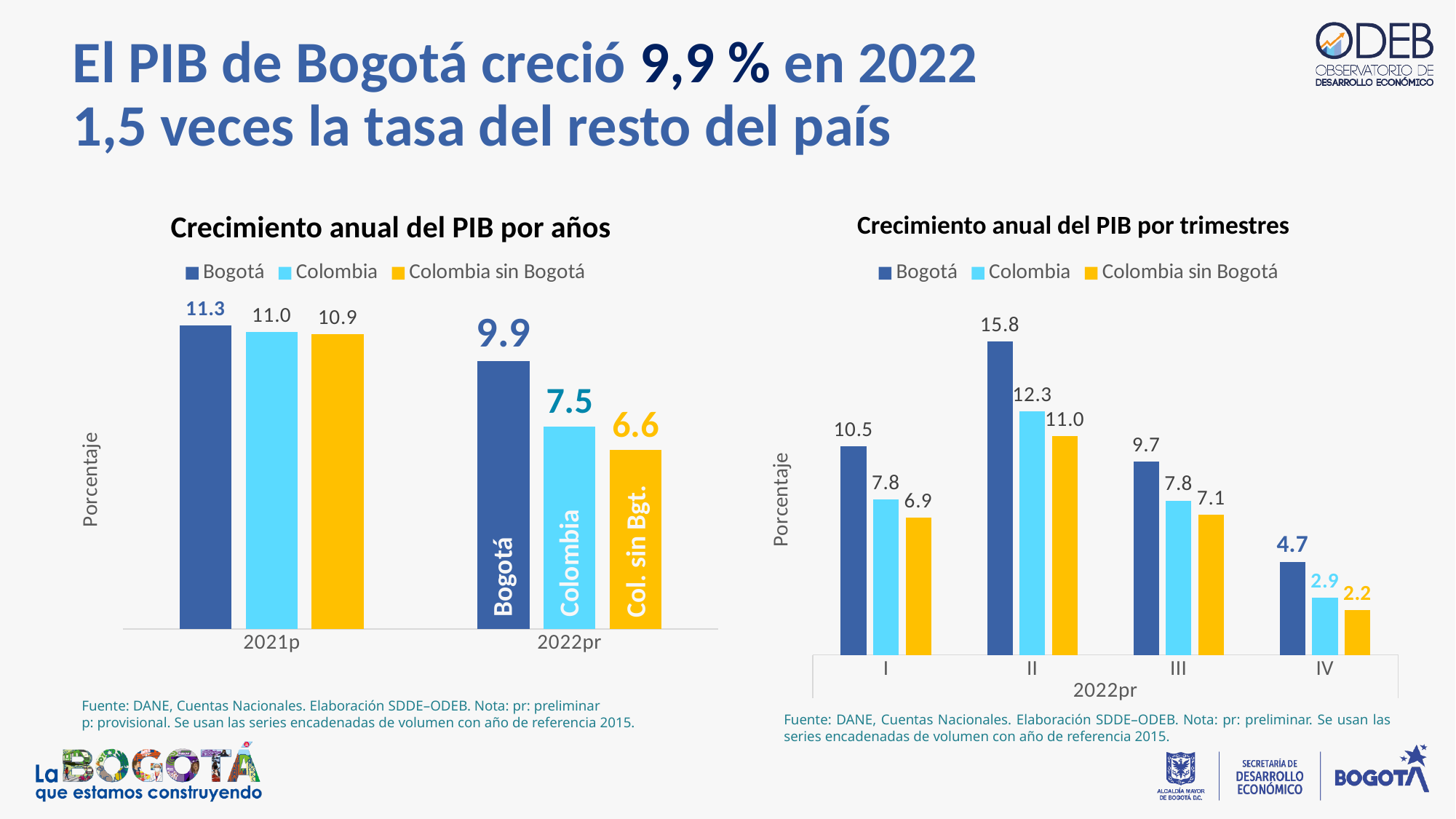
In the chart 'Crecimiento anual del PIB por años', what is the difference between Bogotá and Colombia sin Bogotá in 2022pr? 3.3 In the chart 'Crecimiento anual del PIB por años', does the Bogotá value rise or fall from 2021p to 2022pr? fall In the chart 'Crecimiento anual del PIB por años', what is the value for Bogotá in 2022pr? 9.9 In the chart 'Crecimiento anual del PIB por trimestres', what is the value for Bogotá in quarter II? 15.8 In the chart 'Crecimiento anual del PIB por años', what is the value for Colombia sin Bogotá in 2021p? 10.9 In the chart 'Crecimiento anual del PIB por años', how many series does the legend list? 3 In the chart 'Crecimiento anual del PIB por trimestres', what is the difference between Bogotá and Colombia in quarter I? 2.7 In the chart 'Crecimiento anual del PIB por trimestres', what is the value for Colombia in quarter IV? 2.9 In the chart 'Crecimiento anual del PIB por trimestres', which quarter has the lowest Colombia sin Bogotá value? IV In the chart 'Crecimiento anual del PIB por trimestres', which quarter has the highest Bogotá value? II In the chart 'Crecimiento anual del PIB por trimestres', how many quarters are shown on the x axis? 4 What kind of chart is 'Crecimiento anual del PIB por trimestres'? bar chart